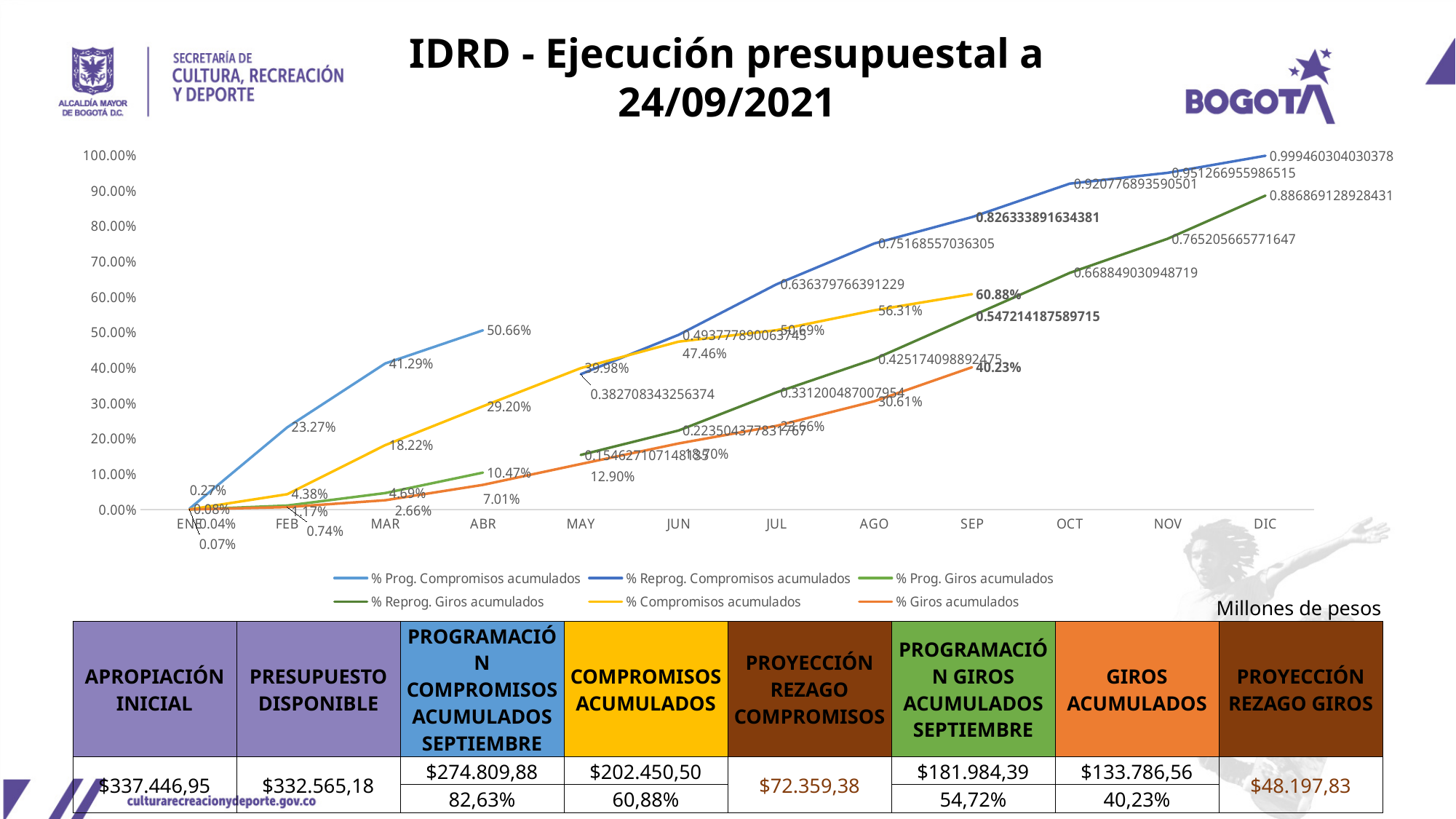
What is the value of % Giros acumulados in SEP? 40.23% What is the value of % Compromisos acumulados in SEP? 60.88% What type of chart is shown on the slide? line chart What is the value of % Prog. Compromisos acumulados in ABR? 50.66% How many series does the chart legend list? 6 What is the difference between % Compromisos acumulados and % Giros acumulados in SEP? 20.65% How many months are shown on the x axis of the chart? 12 What is the value of % Reprog. Giros acumulados in NOV? 0.765205665771647 What is the value of % Reprog. Compromisos acumulados in DIC? 0.999460304030378 In AGO, which is larger: % Compromisos acumulados or % Giros acumulados? % Compromisos acumulados Is the value of % Reprog. Giros acumulados in OCT greater or less than 60.00%? greater Do the values of % Compromisos acumulados rise or fall from ENE to SEP? rise